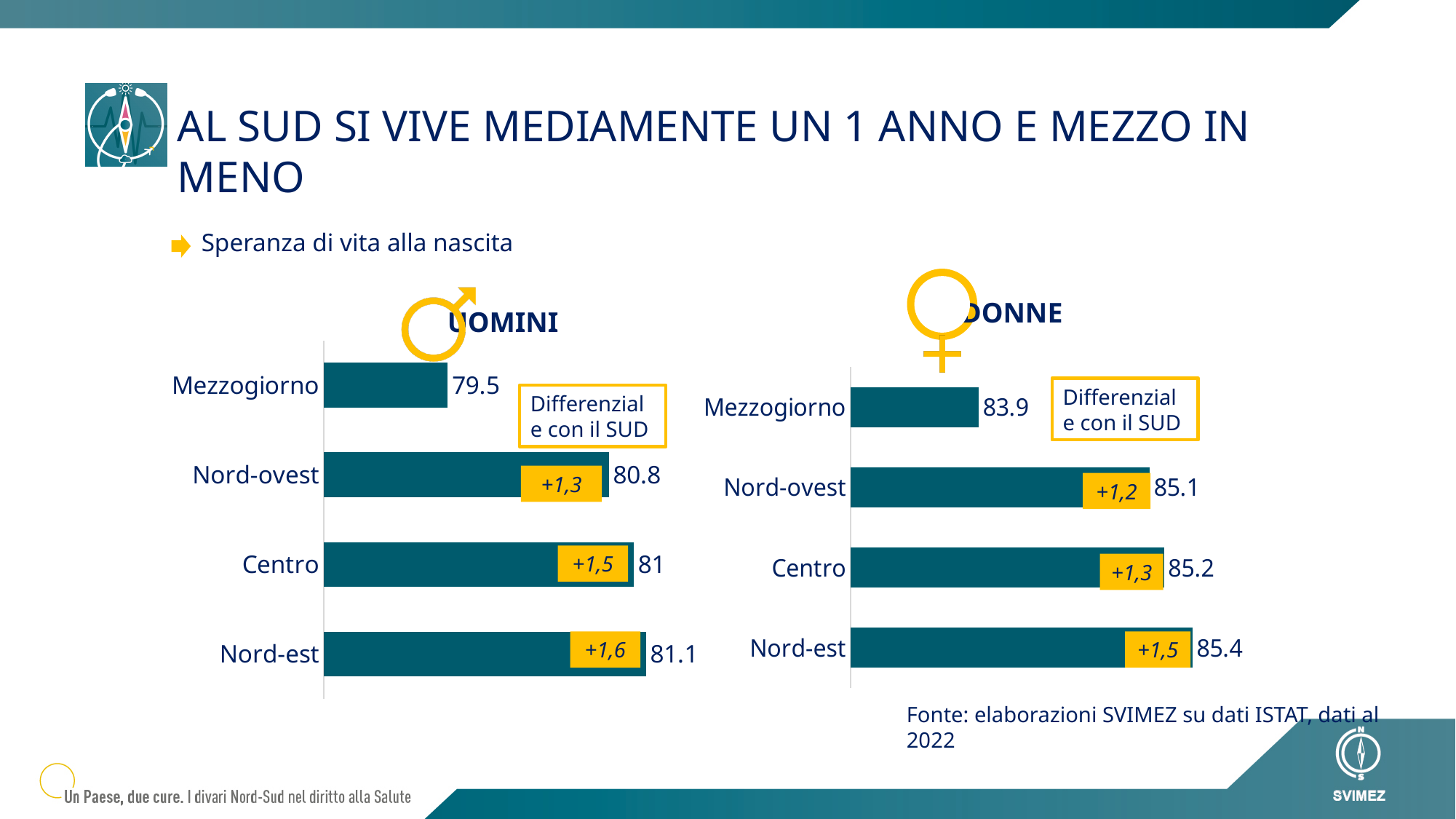
How many regions are shown in the UOMINI chart? 4 In the UOMINI chart, what is the difference between the values for Nord-est and Mezzogiorno? 1.6 In the DONNE chart, what is the value for Nord-ovest? 85.1 In the DONNE chart, what is the difference between the values for Centro and Mezzogiorno? 1.3 In the DONNE chart, which is larger, the value for Nord-ovest or the value for Mezzogiorno? Nord-ovest In the UOMINI chart, what is the value for Centro? 81 In the UOMINI chart, which region has the highest value? Nord-est What type of chart is the DONNE chart? Bar chart In the UOMINI chart, what is the life expectancy value for Mezzogiorno? 79.5 In the DONNE chart, what is the value for Nord-est? 85.4 In the DONNE chart, which region has the lowest value? Mezzogiorno In the UOMINI chart, what differential with the South is shown for Nord-est? +1,6